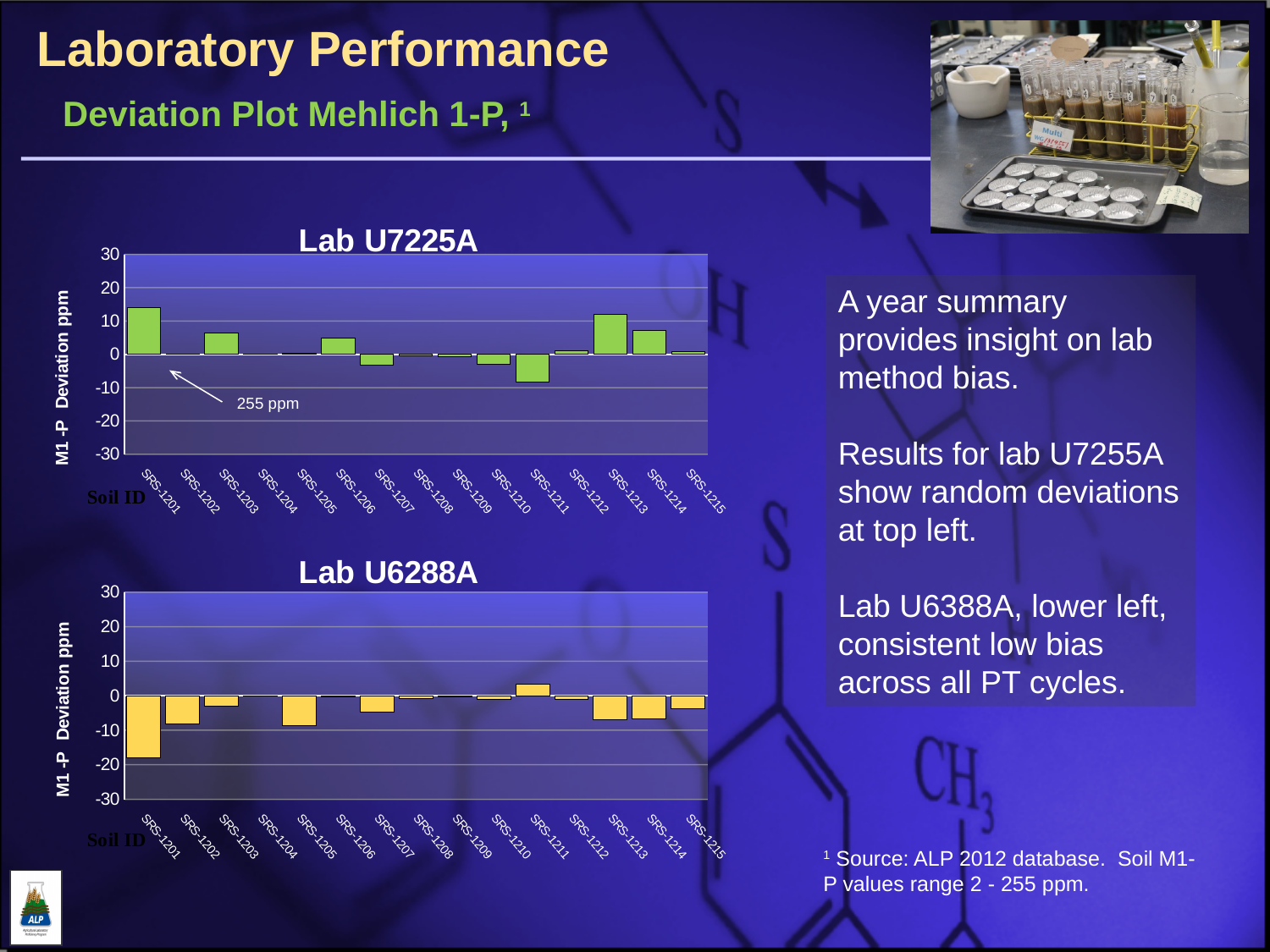
How many soil IDs are plotted on the Lab U6288A chart? 15 On the Lab U7225A chart, is the value for SRS-1210 greater or less than 0? less On the Lab U7225A chart, which is larger, the value for SRS-1203 or the value for SRS-1210? SRS-1203 On the Lab U6288A chart, is the value for SRS-1201 greater or less than -10? less What kind of chart is the Lab U7225A chart? bar chart On the Lab U7225A chart, which soil ID has the lowest deviation? SRS-1211 On the Lab U6288A chart, which soil ID has the highest deviation? SRS-1211 On the Lab U6288A chart, which soil ID has the lowest deviation? SRS-1201 On the Lab U6288A chart, which is larger, the value for SRS-1210 or the value for SRS-1202? SRS-1210 On the Lab U7225A chart, is the value for SRS-1201 greater or less than 10? greater What is the title of the lower chart on the slide? Lab U6288A What is the y-axis label on the Lab U6288A chart? M1 -P Deviation ppm